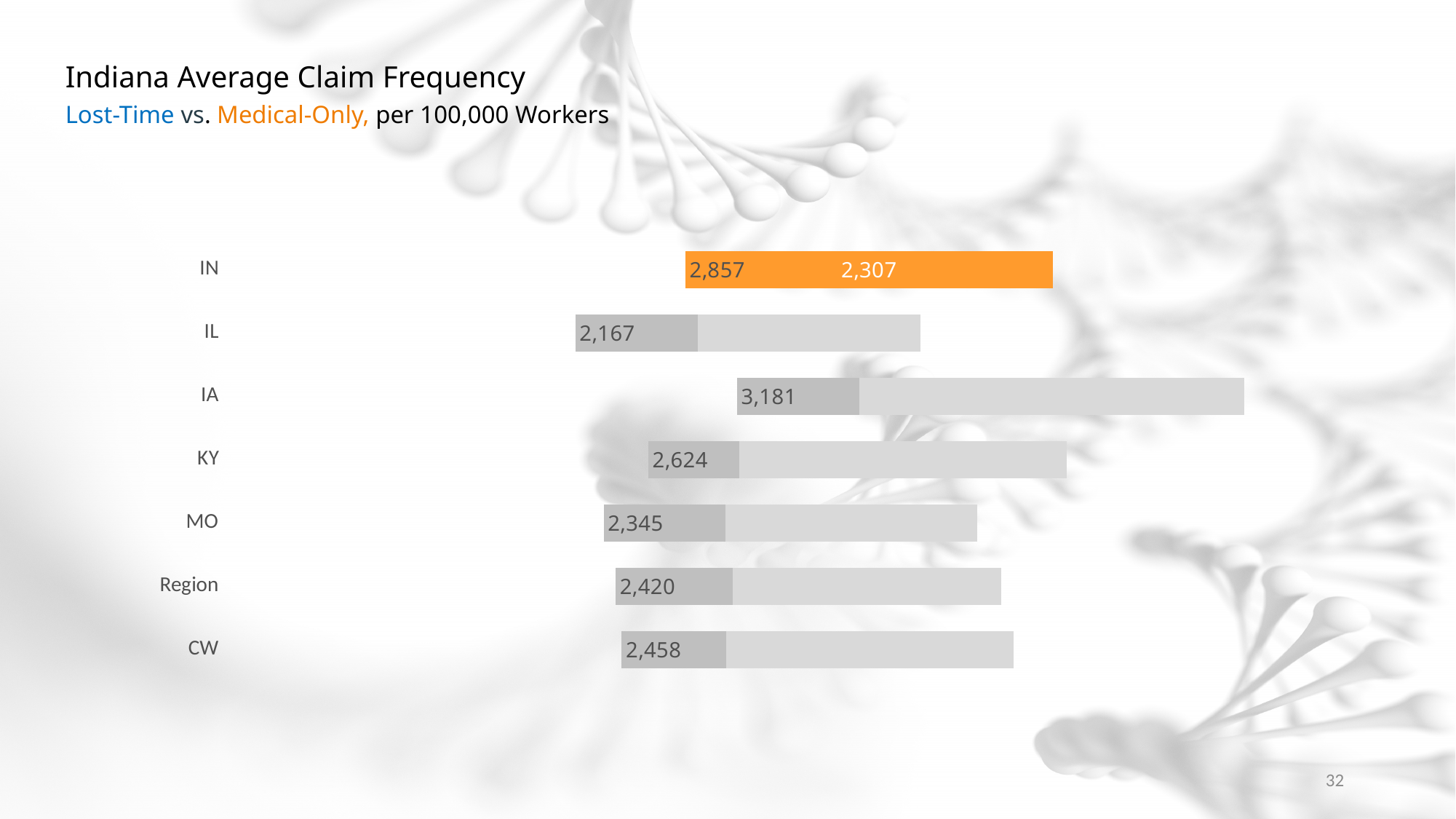
Which category has the highest value printed on its bar? IA What value is printed on the IL bar? 2,167 What value is printed on the IA bar? 3,181 What value is printed on the KY bar? 2,624 Which category has the lowest value printed on its bar? IL What is the difference between the two values printed on the IN bar, 2,857 and 2,307? 550 What is the second value printed on the IN bar? 2,307 Which bar is highlighted in orange? IN How many categories are listed on the chart? 7 What value is printed on the CW bar? 2,458 What type of chart is shown on the slide? bar chart What is the first value printed on the IN bar? 2,857